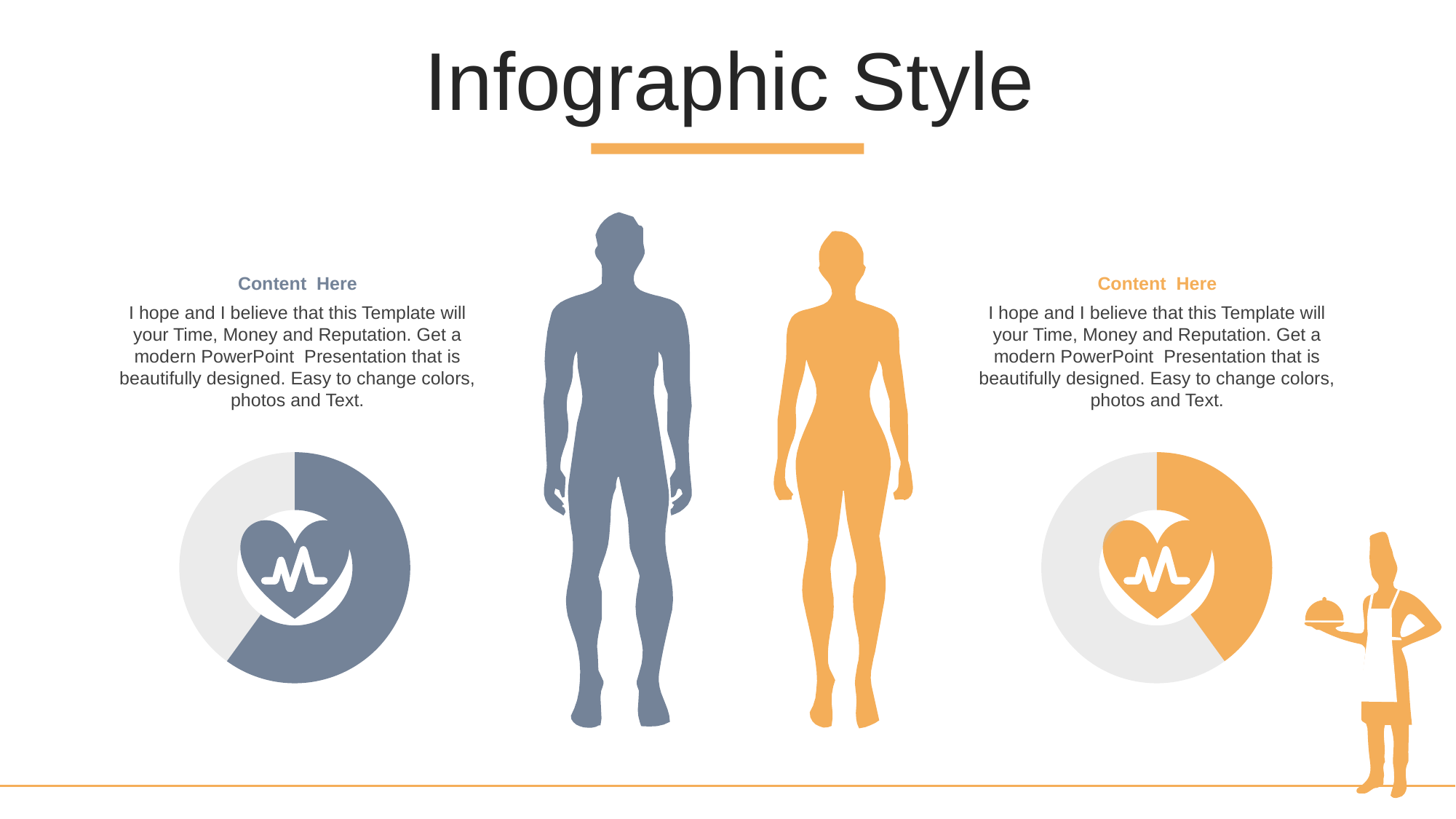
In the left chart, how many slices does the pie have? 2 What kind of chart is shown on the right side of the slide? doughnut chart In the left chart, which slice is larger, the blue-grey slice or the light grey slice? the blue-grey slice What colour is the highlighted slice in the right chart? orange In the right chart, which slice is larger, the orange slice or the light grey slice? the light grey slice What kind of chart is shown on the left side of the slide? doughnut chart What icon is placed in the centre of both charts? a heart with a heartbeat line In the right chart, how many slices does the pie have? 2